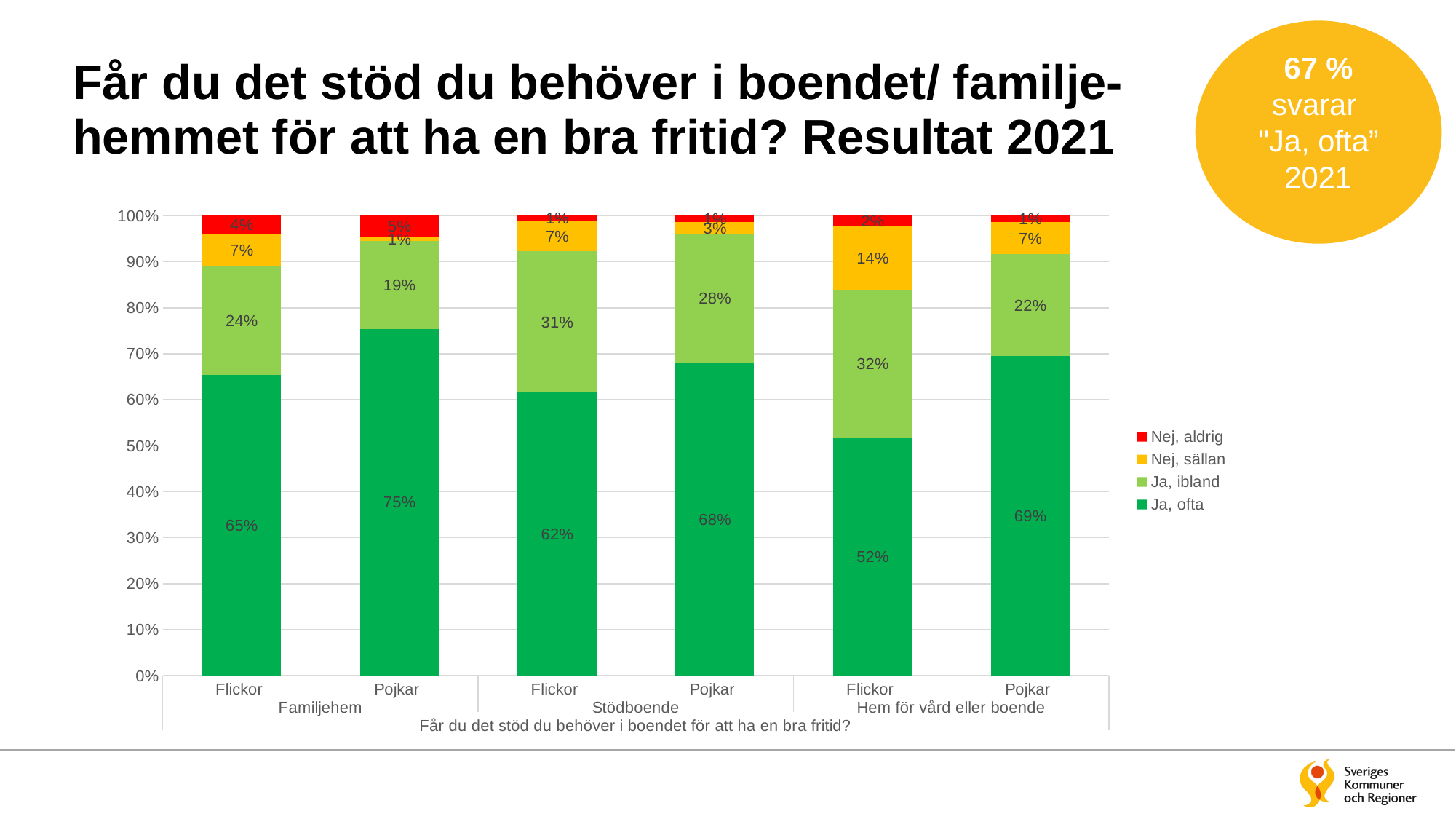
Which colour represents "Nej, aldrig" in the legend? Red Which bar has the lowest share of "Ja, ofta"? Flickor, Hem för vård eller boende How many bars are shown in the chart? 6 How many series does the legend list? 4 What is the difference in the "Ja, ofta" share between Pojkar and Flickor in Hem för vård eller boende? 17 percentage points Is the "Ja, ofta" value for Flickor in Hem för vård eller boende greater or less than 60%? less What kind of chart is shown on the slide? Stacked bar chart What percentage of Pojkar in Stödboende answered "Ja, ibland"? 28% What percentage of Flickor in Hem för vård eller boende answered "Nej, sällan"? 14% Which bar has the highest share of "Ja, ofta"? Pojkar, Familjehem Which has a larger "Ja, ibland" share: Flickor in Stödboende or Pojkar in Stödboende? Flickor in Stödboende What percentage of Flickor in Familjehem answered "Ja, ofta"? 65%